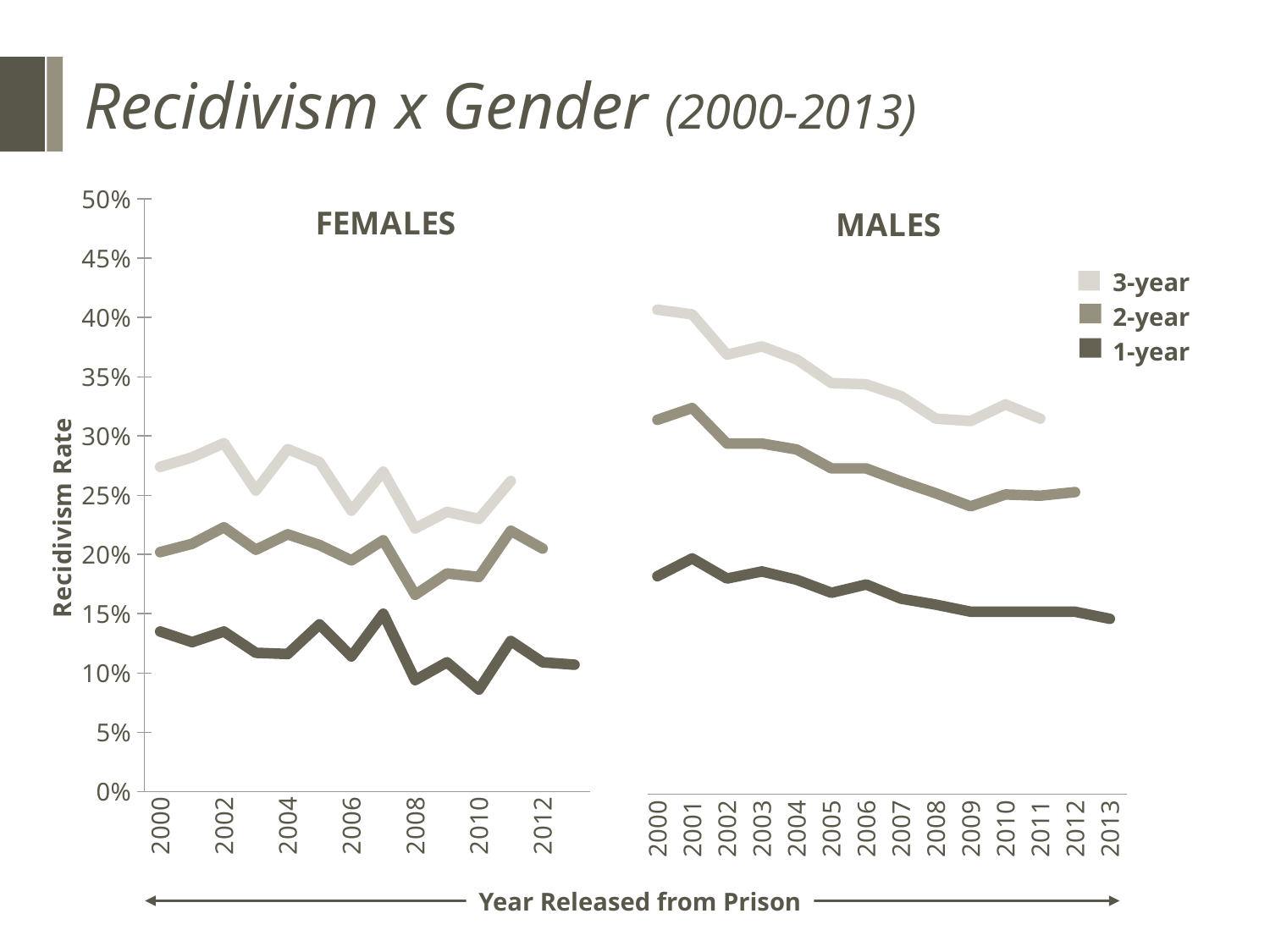
What kind of chart is used for the FEMALES and MALES panels on this slide? line chart In the FEMALES chart, is the 3-year value for 2002 greater or less than 25%? greater In the MALES chart, does the 3-year recidivism rate generally rise or fall from 2000 to 2011? fall What is the label on the vertical axis? Recidivism Rate In the MALES chart, is the 3-year value for 2000 greater or less than 35%? greater In the MALES chart, does the 1-year recidivism rate generally rise or fall from 2000 to 2013? fall How many series does the legend list? 3 In the MALES chart, how many years are labelled on the x axis? 14 In the FEMALES chart, is the 2-year value for 2008 greater or less than 20%? less What are the three series named in the legend? 3-year, 2-year, 1-year Which is larger: the 3-year rate for 2000 in the MALES chart or the 3-year rate for 2000 in the FEMALES chart? MALES